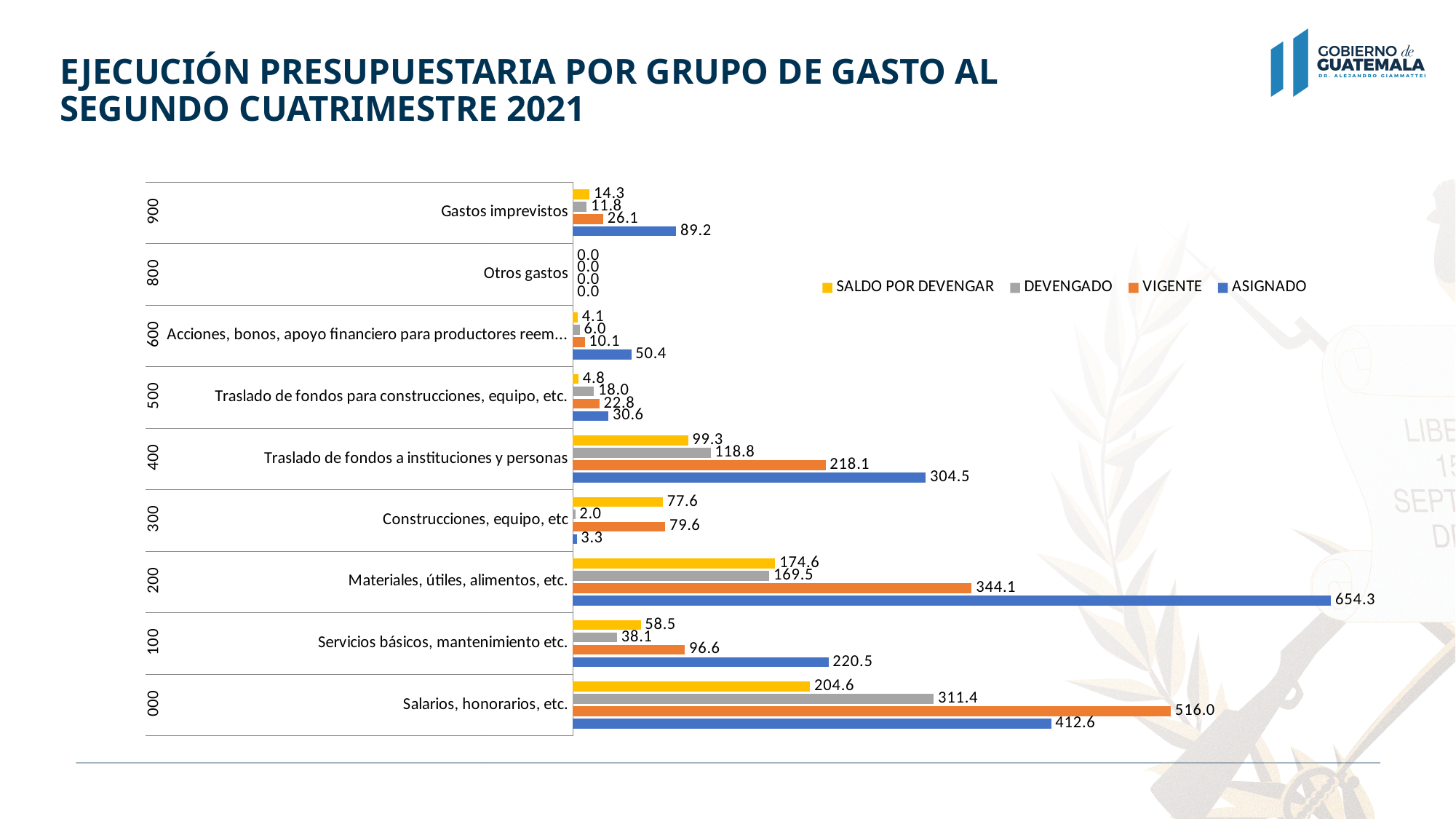
How many expense group categories are shown on the chart? 9 Which is larger for Construcciones, equipo, etc: the SALDO POR DEVENGAR value or the DEVENGADO value? SALDO POR DEVENGAR What is the SALDO POR DEVENGAR value for Servicios básicos, mantenimiento etc.? 58.5 What is the DEVENGADO value for Salarios, honorarios, etc.? 311.4 What is the difference between the VIGENTE and ASIGNADO values for Salarios, honorarios, etc.? 103.4 How many series does the legend list? 4 What is the ASIGNADO value for Materiales, útiles, alimentos, etc.? 654.3 Which category has the highest ASIGNADO value? Materiales, útiles, alimentos, etc. What is the VIGENTE value for Traslado de fondos a instituciones y personas? 218.1 What kind of chart is shown on the slide? Bar chart What is the difference between the ASIGNADO and VIGENTE values for Materiales, útiles, alimentos, etc.? 310.2 Which category has the highest DEVENGADO value? Salarios, honorarios, etc.